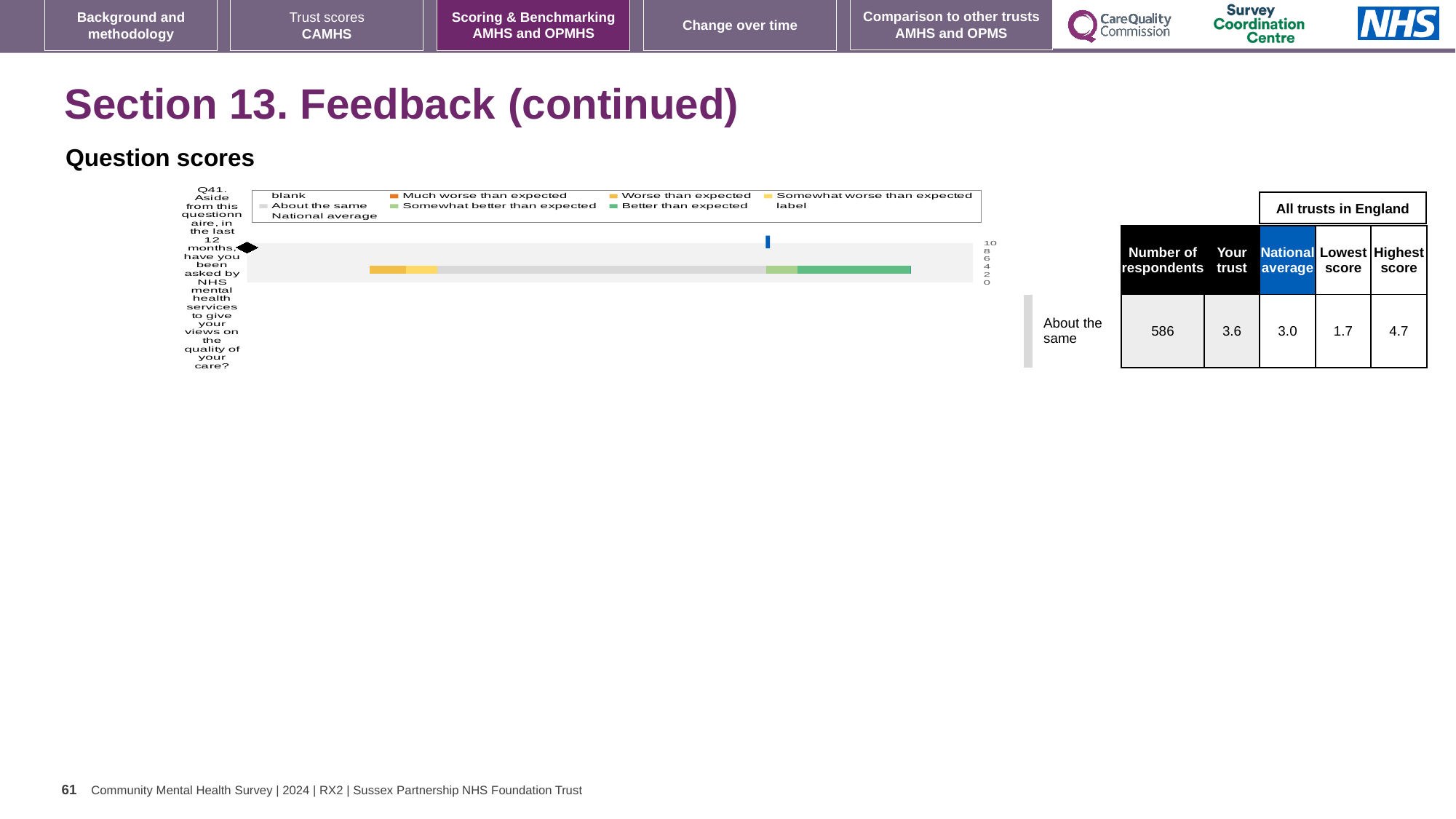
How many survey questions are plotted in the chart? 1 What is the highest score among all trusts in England for Q41? 4.7 What is the national average score for Q41? 3.0 What type of chart is used to show the Q41 question score? bar chart How many respondents answered Q41? 586 What is the difference between the highest score and the lowest score for Q41? 3.0 For Q41, which is higher: the 'Your trust' score or the national average? Your trust By how much does the 'Your trust' score for Q41 exceed the national average? 0.6 Which benchmark category is Q41 labelled with next to the chart? About the same What is the 'Your trust' score for Q41? 3.6 Which legend entry is shown in dark green in the chart? Better than expected What is the lowest score among all trusts in England for Q41? 1.7